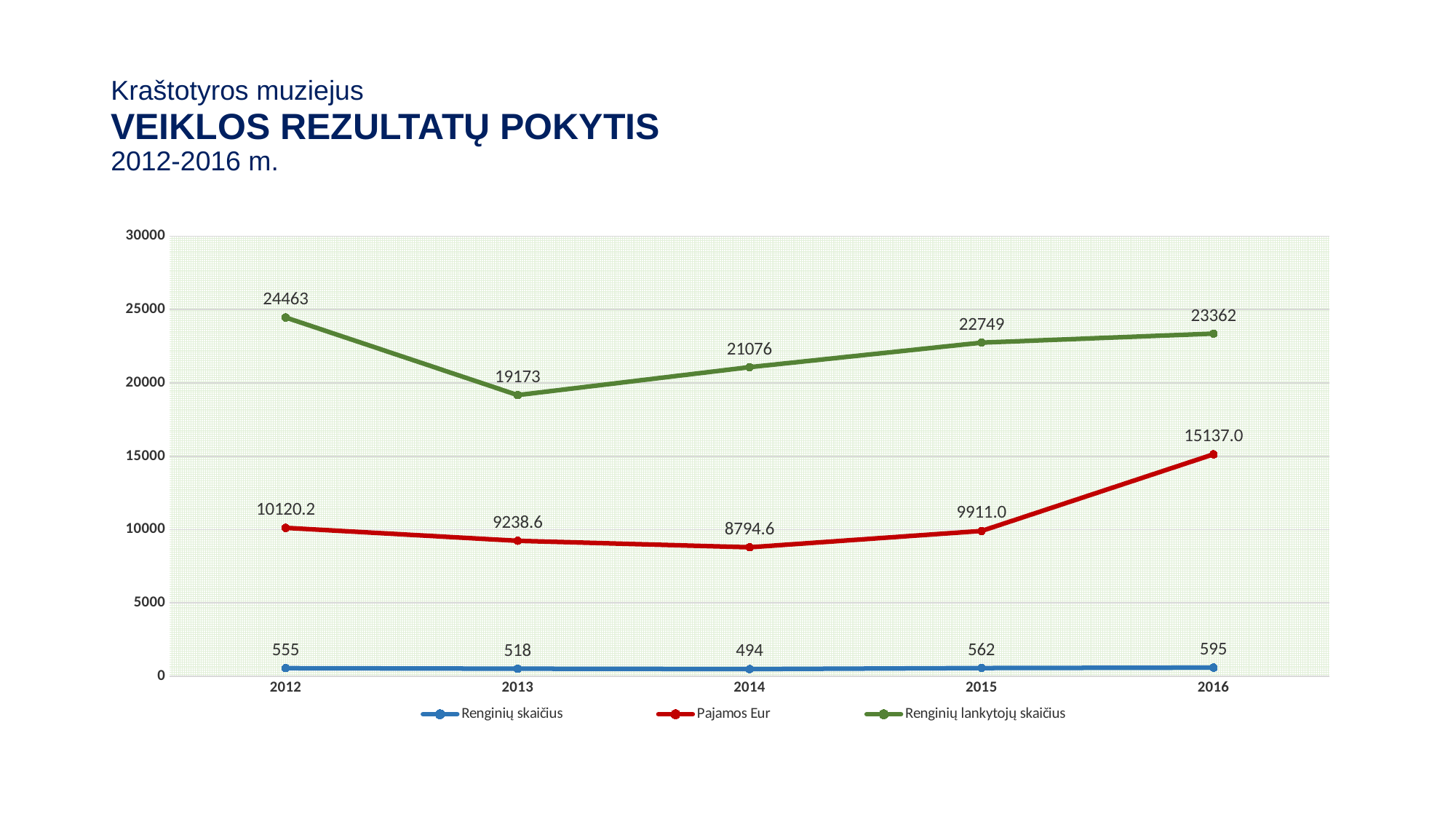
Does Pajamos Eur rise or fall from 2014 to 2016? rise In which year is Pajamos Eur highest? 2016 What is the value of Pajamos Eur in 2016? 15137.0 What is the value of Renginių lankytojų skaičius in 2012? 24463 What kind of chart is shown on the slide? line chart Which is larger: Renginių skaičius in 2015 or in 2013? 2015 What is the difference between Renginių lankytojų skaičius in 2016 and in 2015? 613 What is the value of Renginių skaičius in 2014? 494 In which year is Renginių lankytojų skaičius lowest? 2013 How many years are plotted on the x axis? 5 How many series does the legend list? 3 Which series is drawn in green? Renginių lankytojų skaičius